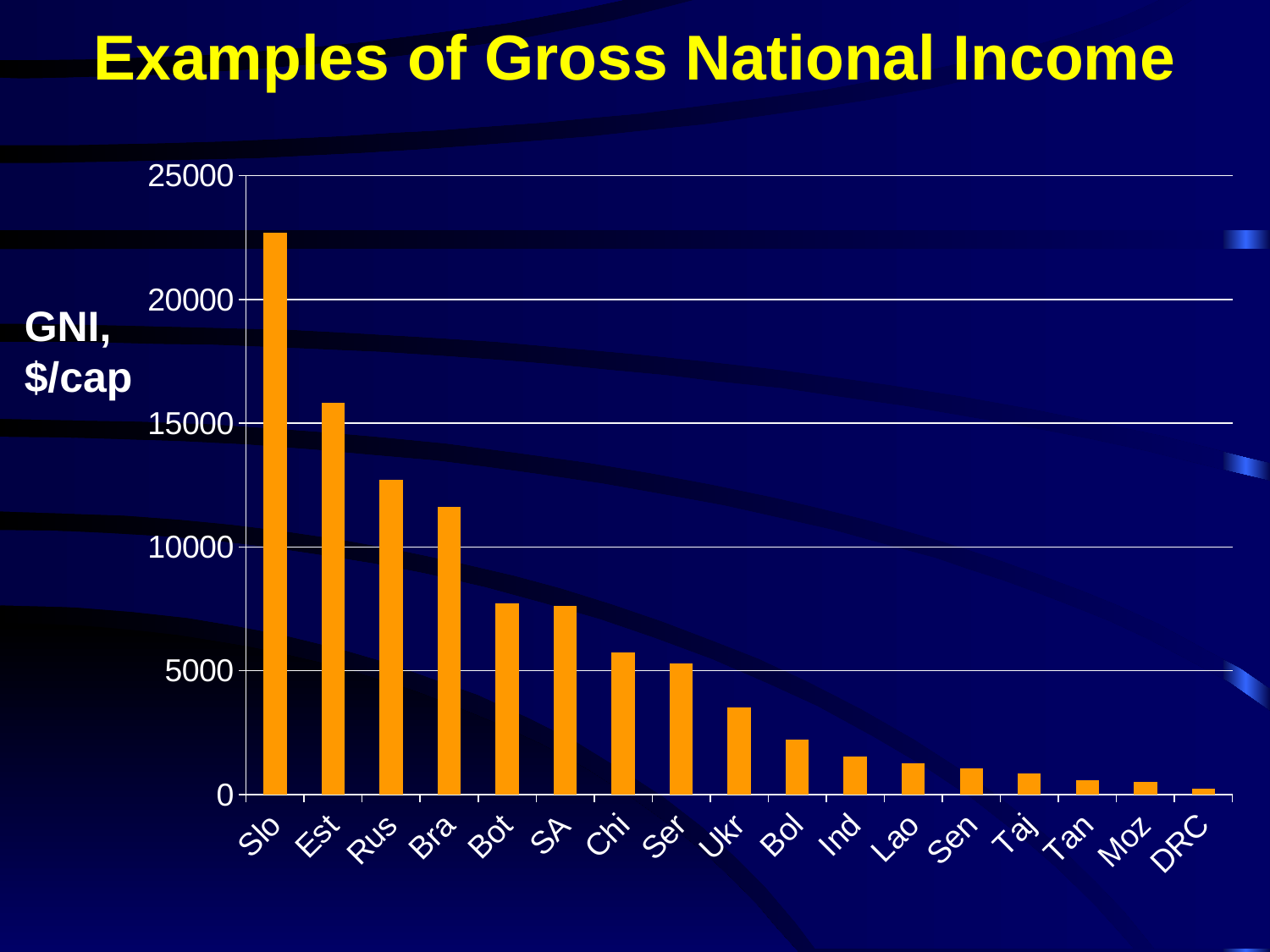
What kind of chart is shown on the slide? bar chart Is the value for Bot greater or less than 10000? less Do the values rise or fall moving from left to right along the x axis? fall Is the value for Slo greater or less than 20000? greater How many countries are shown on the x axis of the chart? 17 Which has a larger GNI per capita, Est or Rus? Est Which country has the highest GNI per capita in the chart? Slo Is the value for Ukr greater or less than 5000? less Which country has the lowest GNI per capita in the chart? DRC What is the label on the vertical axis of the chart? GNI, $/cap